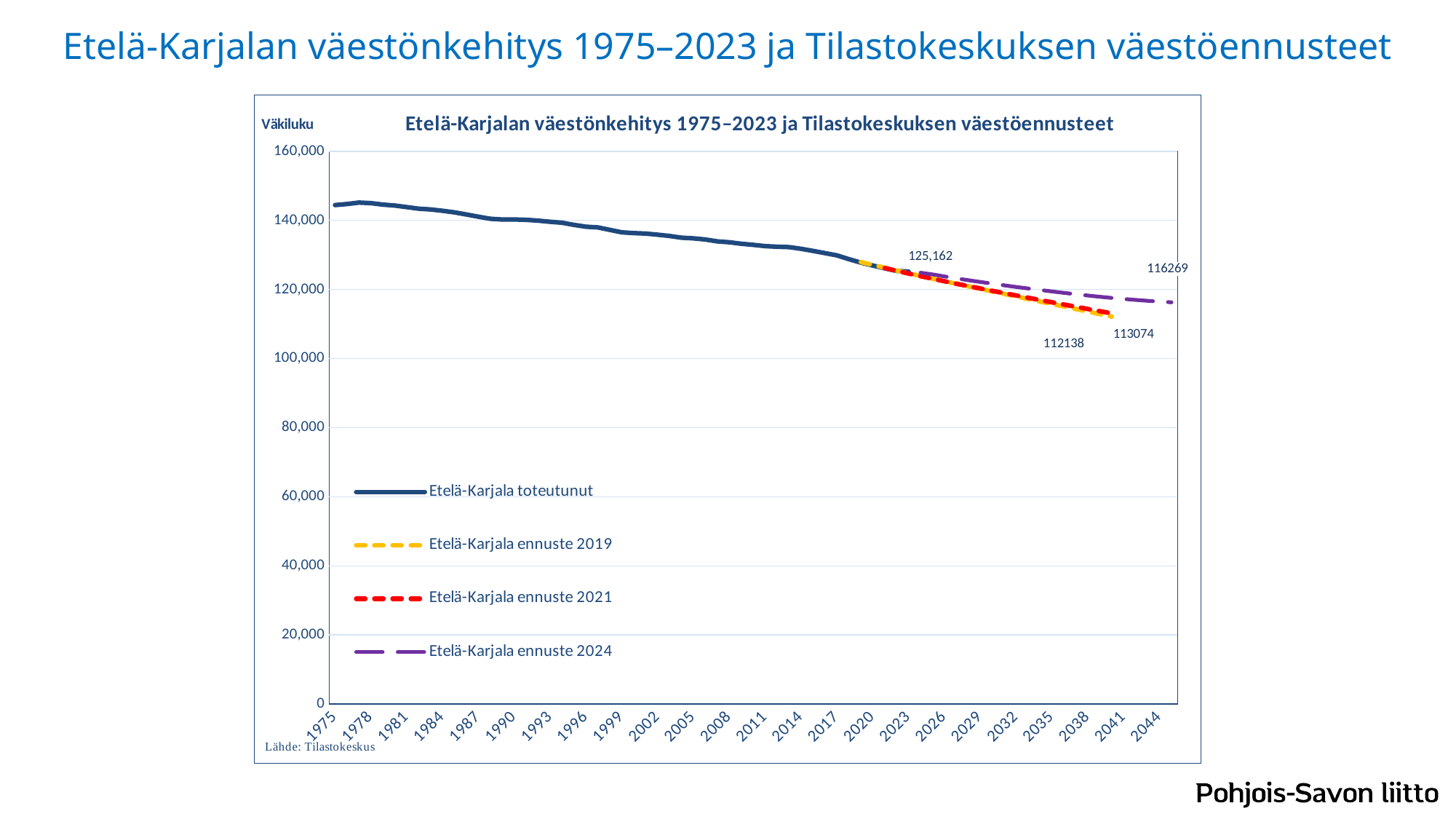
What value is labelled at the end of the Etelä-Karjala toteutunut line, around 2023? 125,162 Is the Etelä-Karjala toteutunut value for 1975 greater or less than 140,000? greater Is the Etelä-Karjala toteutunut value for 2005 greater or less than 140,000? less What label is shown on the vertical axis of the chart? Väkiluku What type of chart is shown on the slide? line chart Does the Etelä-Karjala toteutunut line rise or fall from 1975 to 2023? fall How many series does the legend list? 4 What source is cited below the chart? Tilastokeskus Which forecast series ends at the highest value? Etelä-Karjala ennuste 2024 What value is labelled at the end of the Etelä-Karjala ennuste 2024 line? 116269 Is the Etelä-Karjala toteutunut value for 2014 greater or less than 120,000? greater What is the difference between the labelled value 125,162 on the toteutunut line and the labelled end value 116269 of the ennuste 2024 line? 8,893